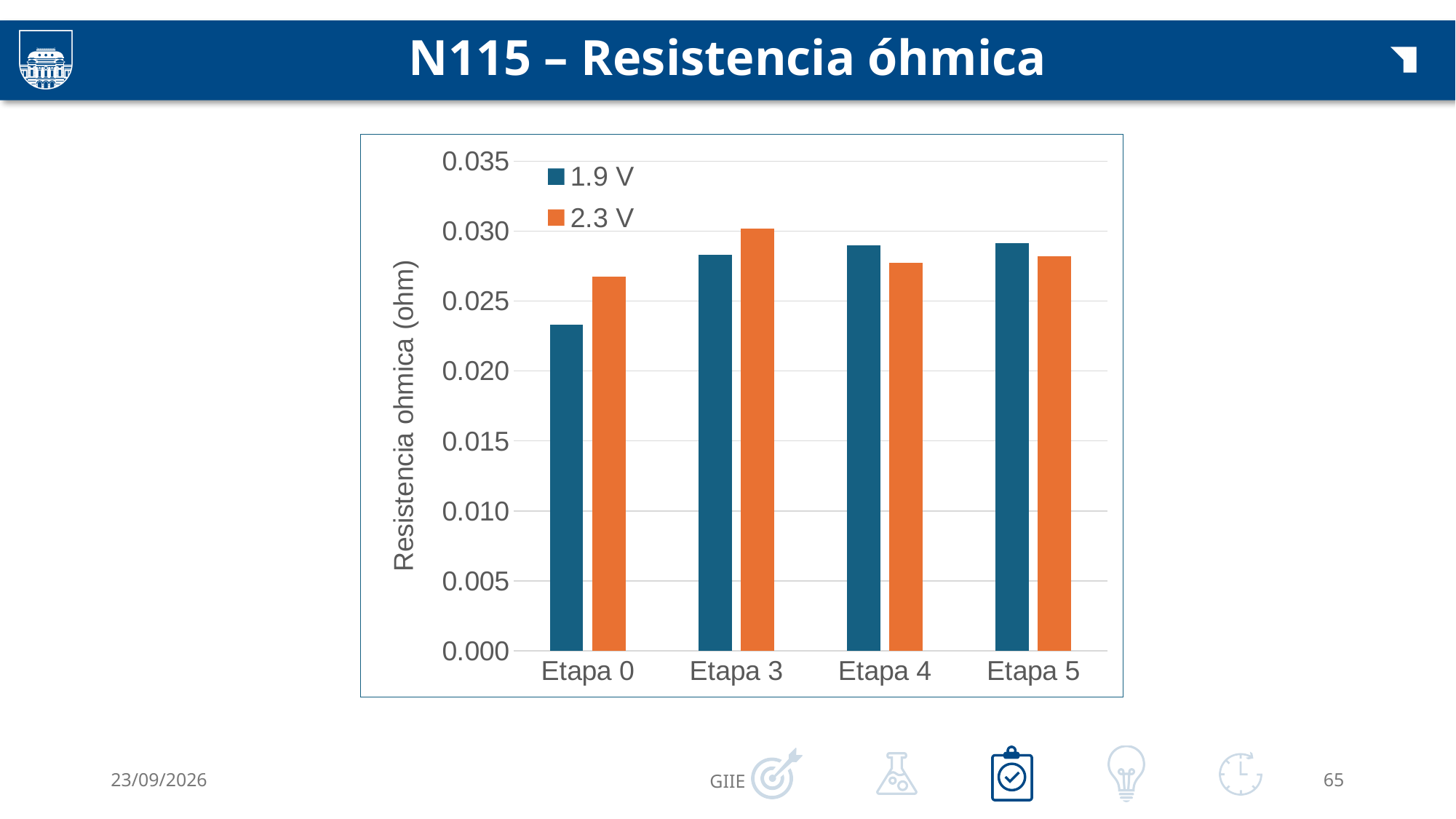
Is the value for 1.9 V at Etapa 0 greater or less than 0.025? less How many categories (etapas) are shown on the x axis? 4 Which etapa has the highest value for the 2.3 V series? Etapa 3 Which etapa has the lowest value for the 2.3 V series? Etapa 0 What is the label of the y axis? Resistencia ohmica (ohm) At Etapa 0, which series has the larger value, 1.9 V or 2.3 V? 2.3 V How many series does the legend list? 2 Which etapa has the lowest value for the 1.9 V series? Etapa 0 Does the 1.9 V series rise or fall from Etapa 0 to Etapa 5? rise What kind of chart is shown on the slide? bar chart At Etapa 4, which series has the larger value, 1.9 V or 2.3 V? 1.9 V Is the value for 2.3 V at Etapa 0 greater or less than 0.025? greater